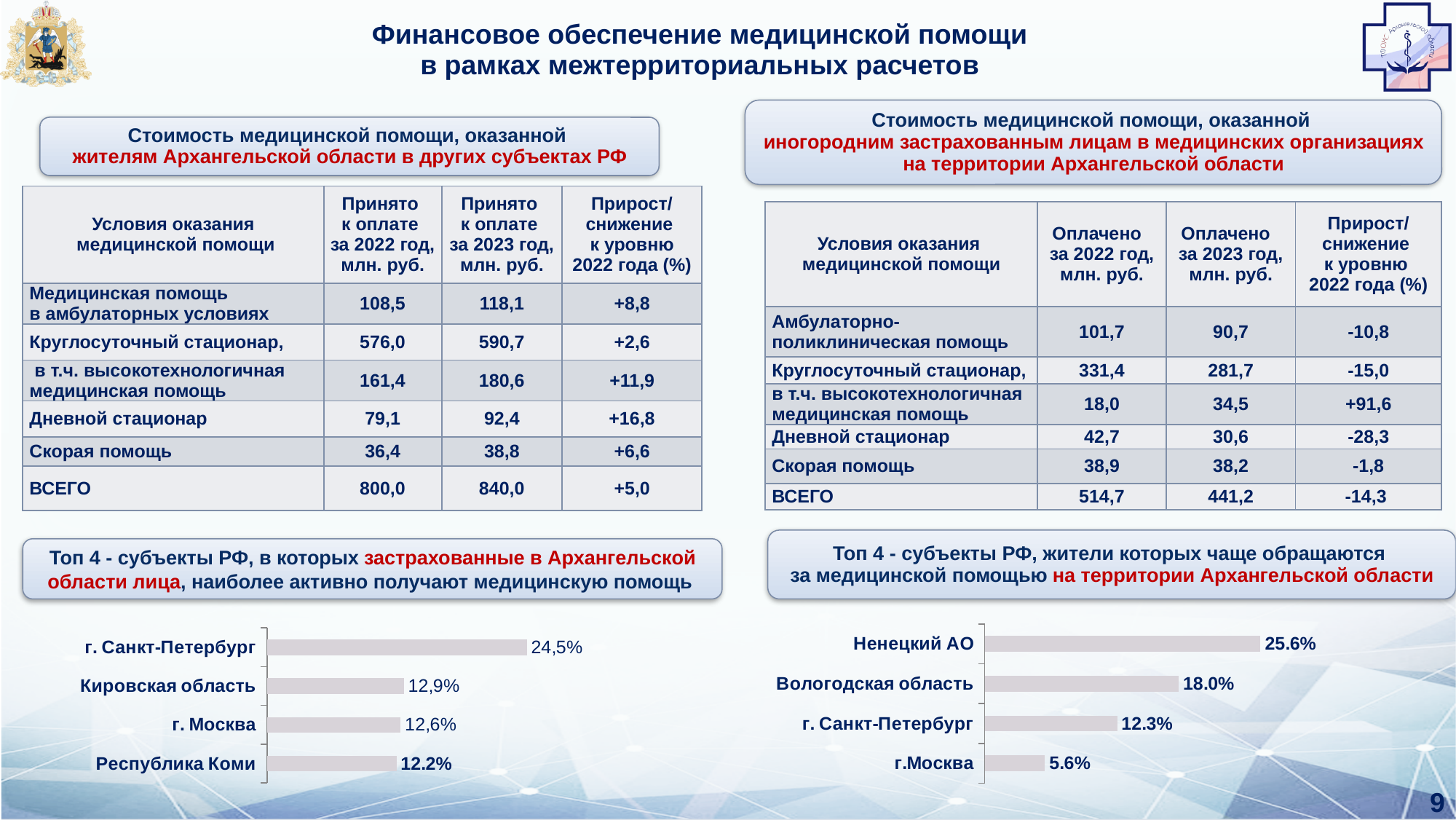
What type of chart is the bottom-left chart? Bar chart In the bottom-right chart, what is the value for г.Москва? 5.6% In the bottom-right chart, what is the value for Вологодская область? 18.0% In the bottom-left chart, what is the value for Кировская область? 12,9% In the bottom-left chart, what is the value for г. Санкт-Петербург? 24,5% In the bottom-right chart, which region has the lowest value? г.Москва In the bottom-left chart, how many regions are shown? 4 In the bottom-right chart, which is larger: the value for г. Санкт-Петербург or the value for г.Москва? г. Санкт-Петербург In the bottom-right chart, what is the value for Ненецкий АО? 25.6% In the bottom-left chart, which region has the highest value? г. Санкт-Петербург In the bottom-right chart, what is the difference between the values for Ненецкий АО and Вологодская область? 7.6% In the bottom-left chart, what is the value for Республика Коми? 12.2%